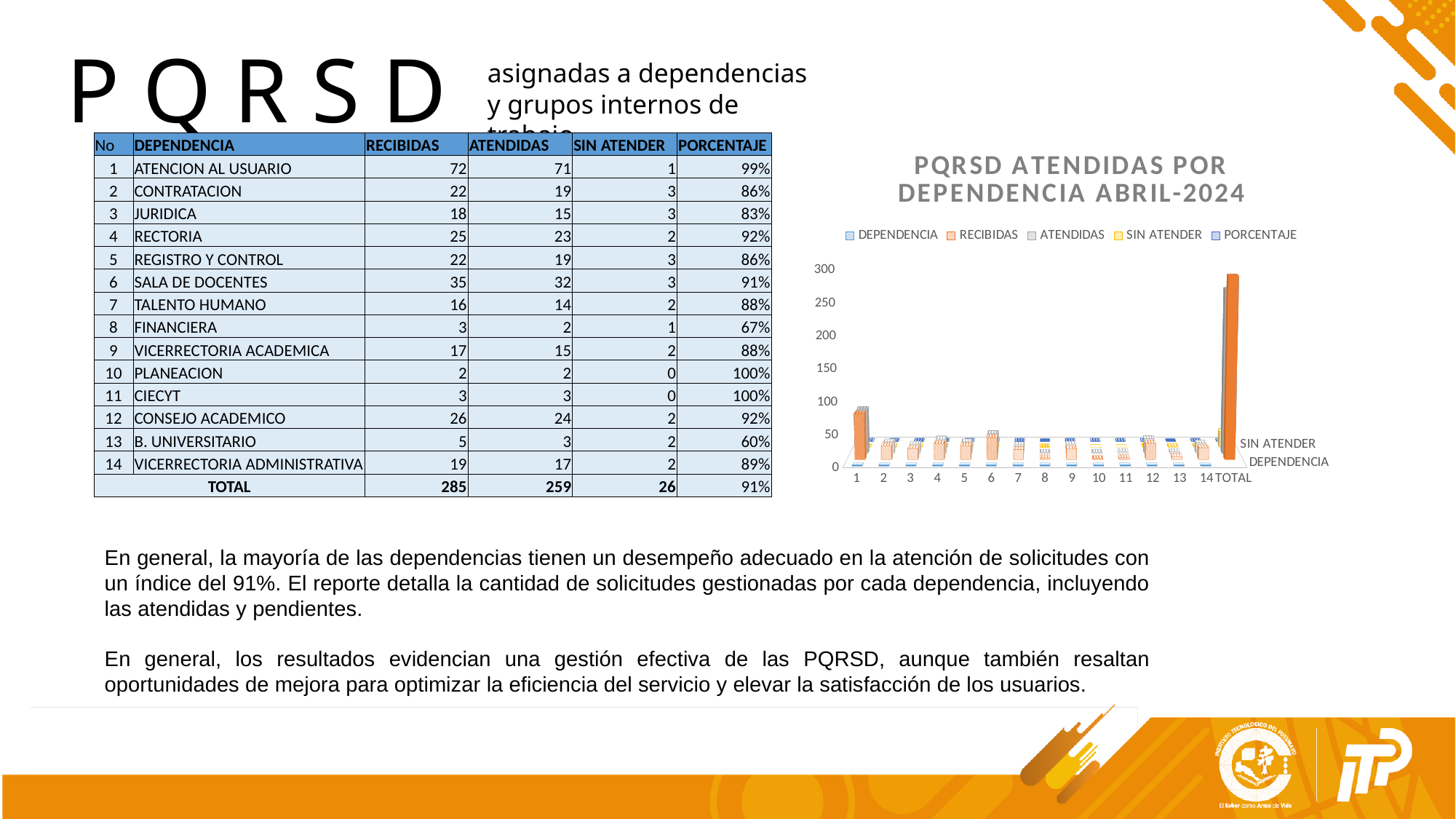
Which has the larger RECIBIDAS bar, category 1 or category 8? category 1 Which x-axis category has the tallest bar in the chart? TOTAL How many categories are shown along the x axis of the chart? 15 What kind of chart is shown on the slide? bar chart Is the RECIBIDAS value for category 8 greater or less than 50? less How many series does the chart legend list? 5 Is the RECIBIDAS value for the TOTAL category greater or less than 250? greater What is the highest value shown on the chart's vertical axis? 300 Which series are listed in the chart legend? DEPENDENCIA, RECIBIDAS, ATENDIDAS, SIN ATENDER, PORCENTAJE What is the title of the chart? PQRSD ATENDIDAS POR DEPENDENCIA ABRIL-2024 Which has the larger RECIBIDAS bar, category 1 or category 6? category 1 Is the RECIBIDAS value for category 1 greater or less than 50? greater